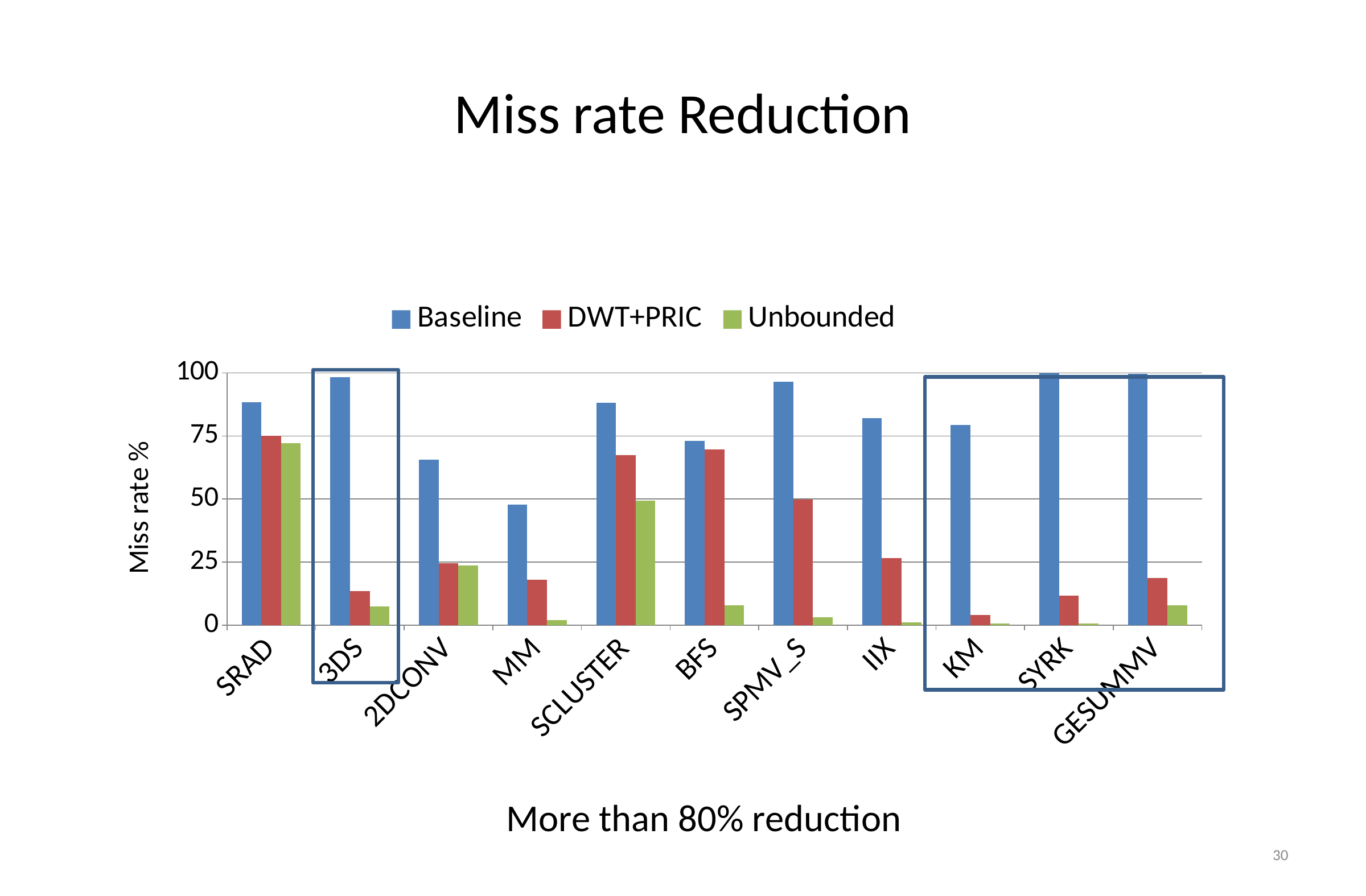
Which category has the lowest DWT+PRIC miss rate? KM What kind of chart is shown on the slide? bar chart Which category has the highest Unbounded miss rate? SRAD Which is larger, the Unbounded value for SRAD or the Unbounded value for SCLUSTER? SRAD Which category has the lowest Baseline miss rate? MM How many benchmark categories are shown on the x axis? 11 Is the DWT+PRIC value for 3DS greater or less than 25? less How many series does the legend list? 3 Which is larger, the Baseline value for SRAD or the Baseline value for 3DS? 3DS Is the Baseline value for MM greater or less than 50? less Is the DWT+PRIC value for SCLUSTER greater or less than 50? greater What is the label on the y axis? Miss rate %